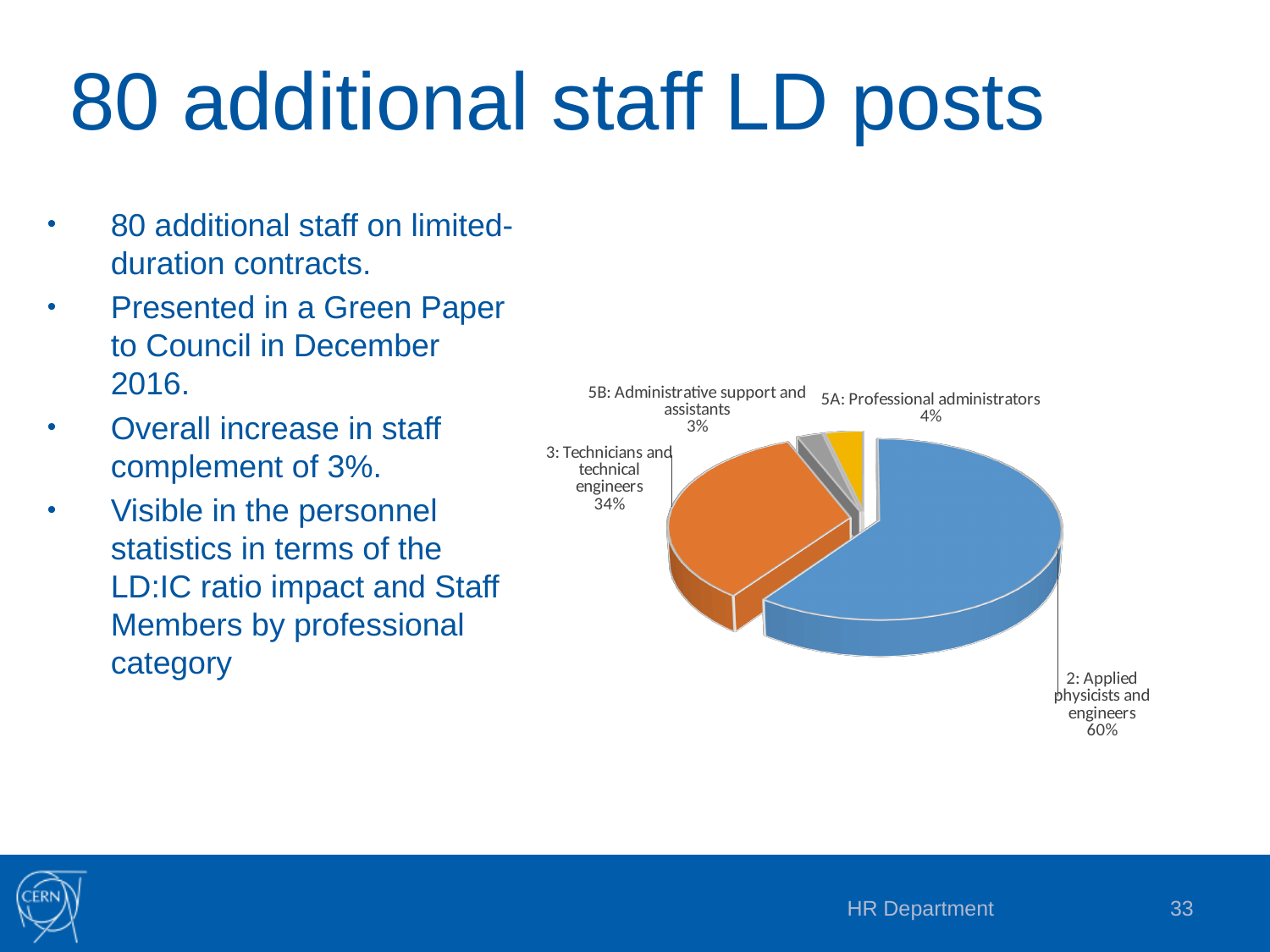
What share of the pie is labelled for '3: Technicians and technical engineers'? 34% What share of the pie is labelled for '5B: Administrative support and assistants'? 3% Which category has the largest slice of the pie? 2: Applied physicists and engineers What share of the pie is labelled for '2: Applied physicists and engineers'? 60% Which slice is larger: '5A: Professional administrators' or '5B: Administrative support and assistants'? 5A: Professional administrators What is the difference in percentage points between the '2: Applied physicists and engineers' slice and the '3: Technicians and technical engineers' slice? 26 Which category has the smallest slice of the pie? 5B: Administrative support and assistants How many slices does the pie chart have? 4 What colour is the '3: Technicians and technical engineers' slice? orange What colour is the '2: Applied physicists and engineers' slice? blue What kind of chart is shown on the slide? pie chart